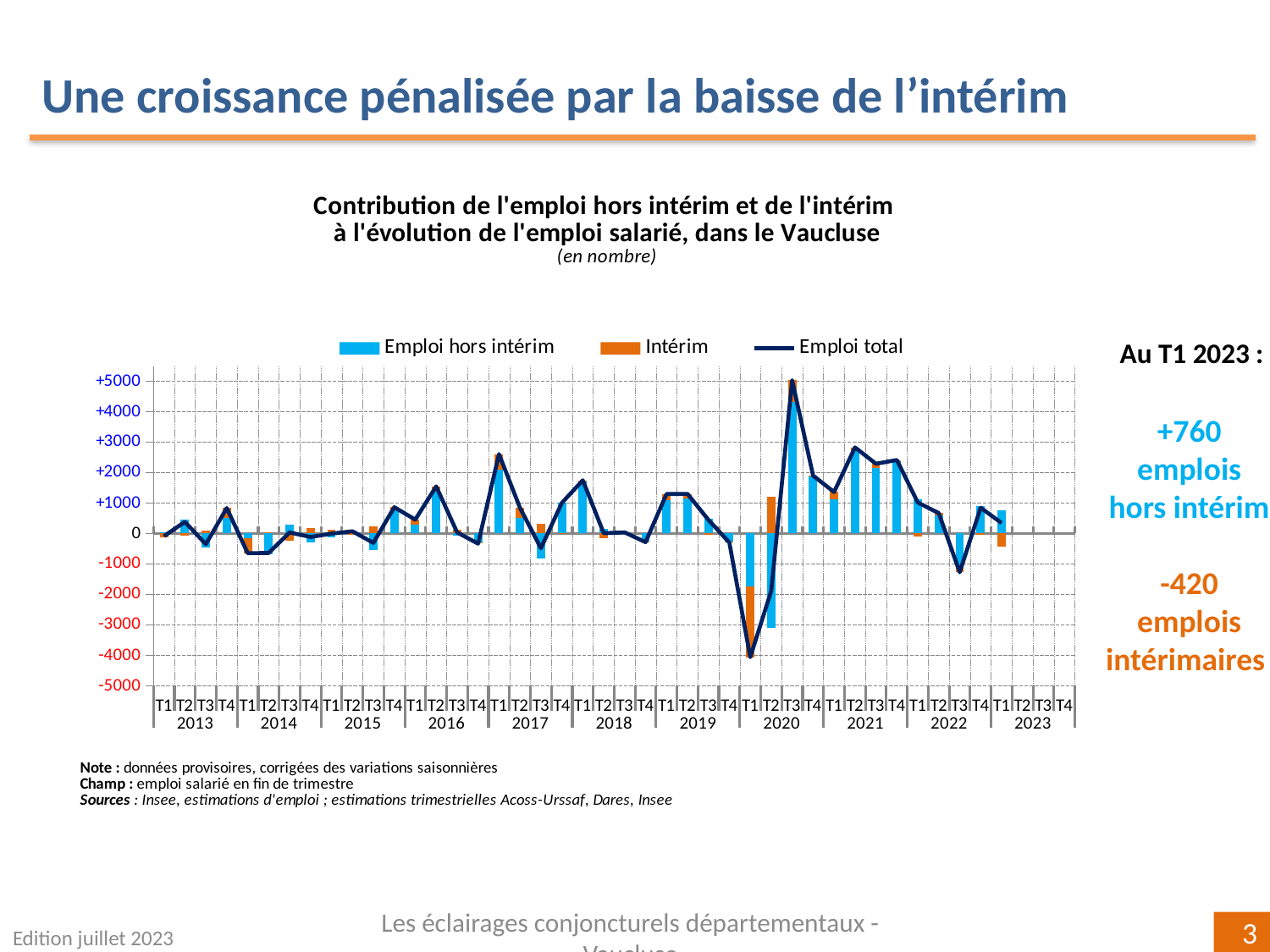
Which series is drawn as a line rather than bars? Emploi total What kind of chart is shown on the slide? A combined bar and line chart Which is larger, the Emploi total value at T3 2020 or at T2 2021? T3 2020 Is the Emploi total value at T1 2020 greater or less than -3000? less Is the Emploi total value at T3 2020 greater or less than 4000? greater In which quarter does the Emploi total line reach its lowest point? T1 2020 In which quarter does the Emploi total line reach its highest point? T3 2020 How many series does the chart legend list? 3 Is the Emploi hors intérim bar at T3 2020 greater or less than 4000? greater According to the slide, what is the value for Intérim at T1 2023? -420 According to the slide, what is the value for Emploi hors intérim at T1 2023? +760 How many years are labelled along the x axis of the chart? 11